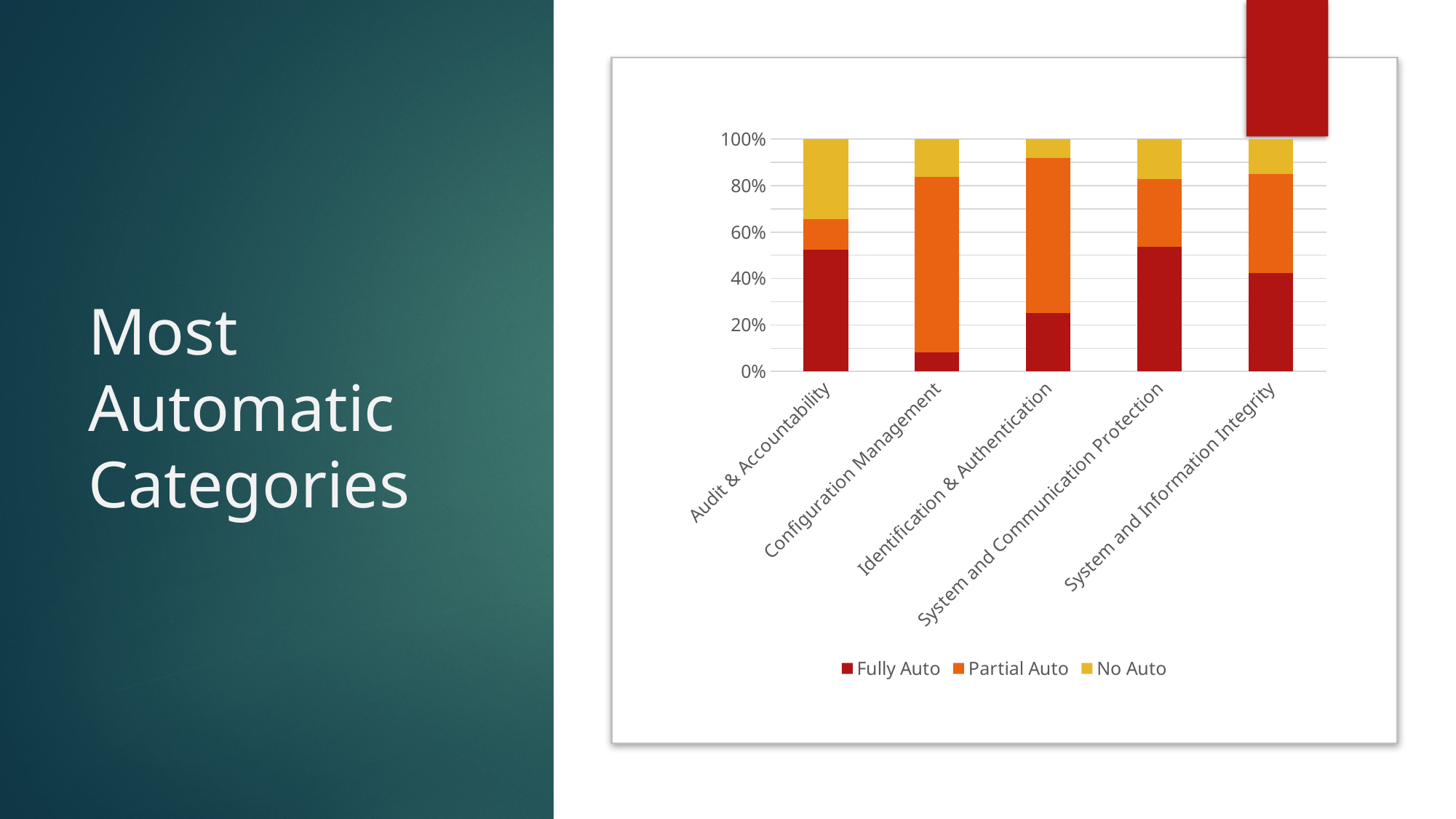
Which has a larger Fully Auto share: Audit & Accountability or Configuration Management? Audit & Accountability What kind of chart is shown on the slide? stacked bar chart Which category has the highest No Auto share? Audit & Accountability Which category has the lowest No Auto share? Identification & Authentication How many categories are shown on the x axis of the chart? 5 Which category has the highest Partial Auto share? Configuration Management Is the Fully Auto value for Audit & Accountability greater or less than 40%? greater Is the Fully Auto value for Configuration Management greater or less than 20%? less How many series does the chart's legend list? 3 What is the total height of the stacked bar for System and Information Integrity? 100% Which category has the lowest Fully Auto share? Configuration Management Which series are listed in the chart's legend? Fully Auto, Partial Auto, No Auto